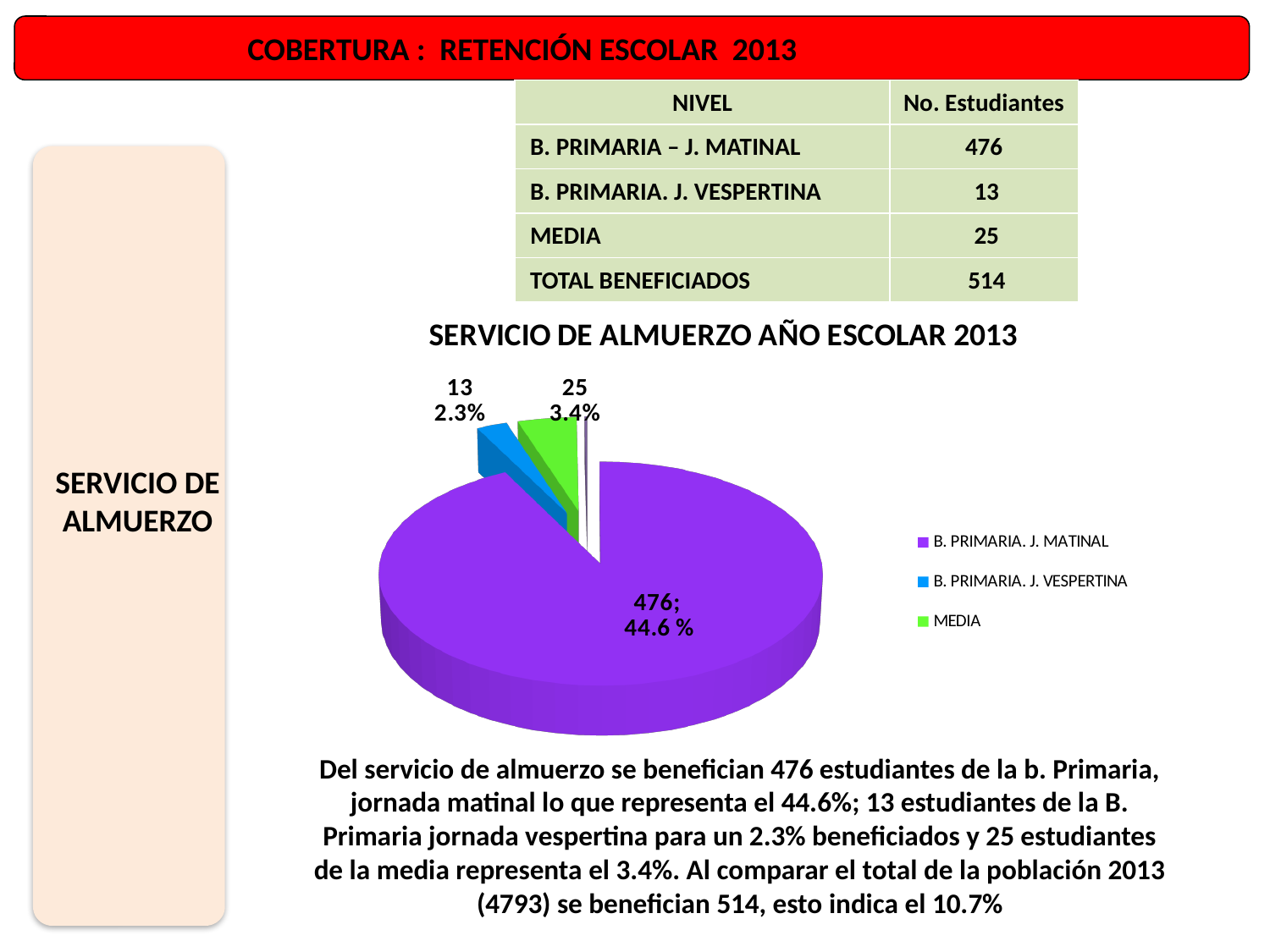
What is the difference between the values for B. PRIMARIA. J. MATINAL and MEDIA? 451 Which is larger, the value for MEDIA or the value for B. PRIMARIA. J. VESPERTINA? MEDIA What is the value shown for MEDIA in the pie chart? 25 Which category has the largest slice in the pie chart? B. PRIMARIA. J. MATINAL What percentage share is labelled on the MEDIA slice? 3.4% How many entries does the chart legend list? 3 What is the value shown for B. PRIMARIA. J. VESPERTINA in the pie chart? 13 What kind of chart is shown on the slide? Pie chart What is the value shown for B. PRIMARIA. J. MATINAL in the pie chart? 476 Which category has the smallest slice in the pie chart? B. PRIMARIA. J. VESPERTINA What is the title of the chart? SERVICIO DE ALMUERZO AÑO ESCOLAR 2013